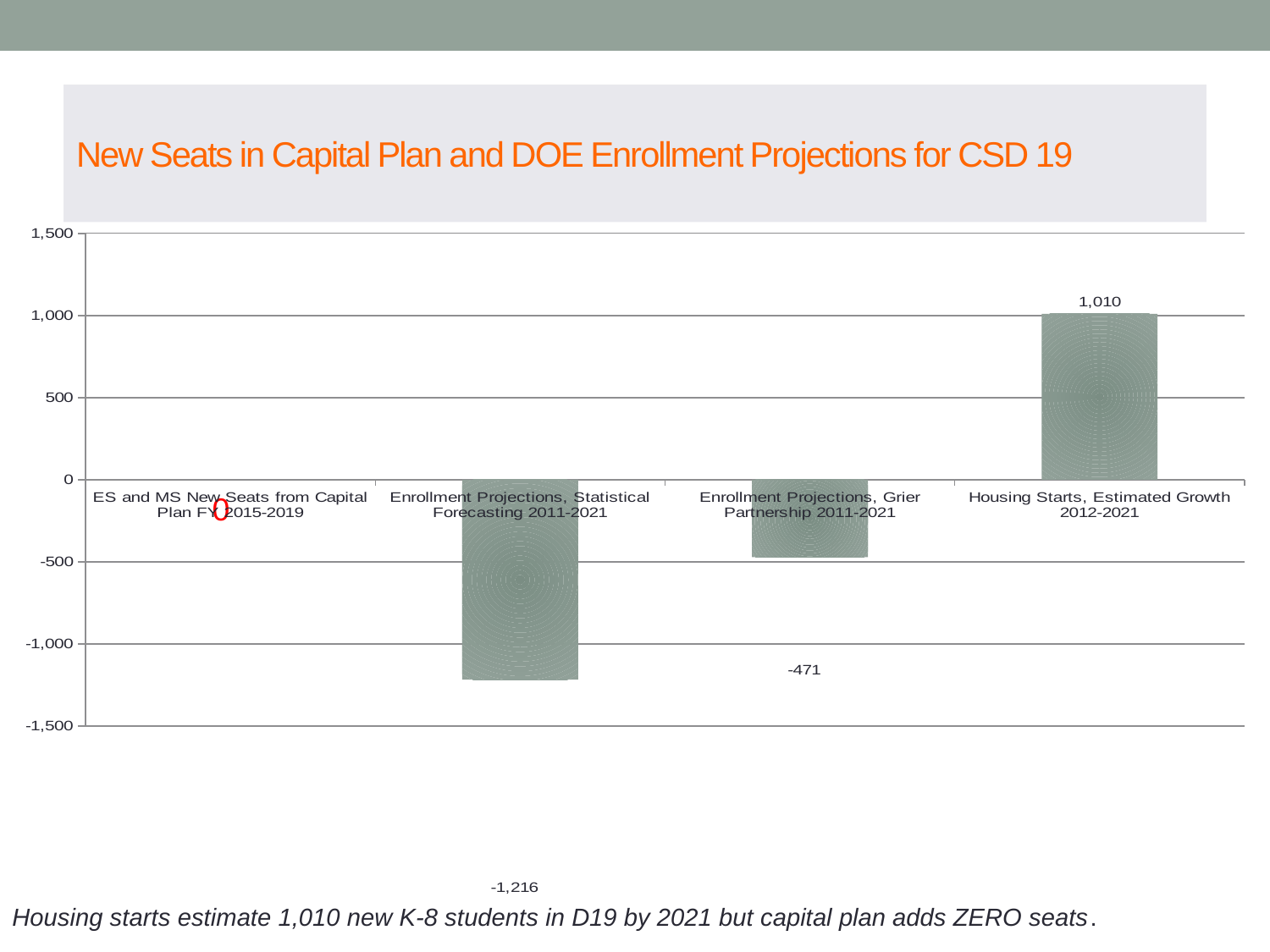
What is the title of the chart? New Seats in Capital Plan and DOE Enrollment Projections for CSD 19 Is the value for Housing Starts, Estimated Growth 2012-2021 greater or less than 1,000? greater Which category has the highest value? Housing Starts, Estimated Growth 2012-2021 How many categories are plotted in the chart? 4 What is the value for Housing Starts, Estimated Growth 2012-2021? 1,010 What is the value for ES and MS New Seats from Capital Plan FY 2015-2019? 0 Which category has the lowest value? Enrollment Projections, Statistical Forecasting 2011-2021 What type of chart is shown on the slide? bar chart What is the value for Enrollment Projections, Grier Partnership 2011-2021? -471 What is the value for Enrollment Projections, Statistical Forecasting 2011-2021? -1,216 Which is larger: the value for Enrollment Projections, Grier Partnership 2011-2021 or the value for Enrollment Projections, Statistical Forecasting 2011-2021? Enrollment Projections, Grier Partnership 2011-2021 What is the difference between the value for Housing Starts, Estimated Growth 2012-2021 and the value for Enrollment Projections, Grier Partnership 2011-2021? 1,481